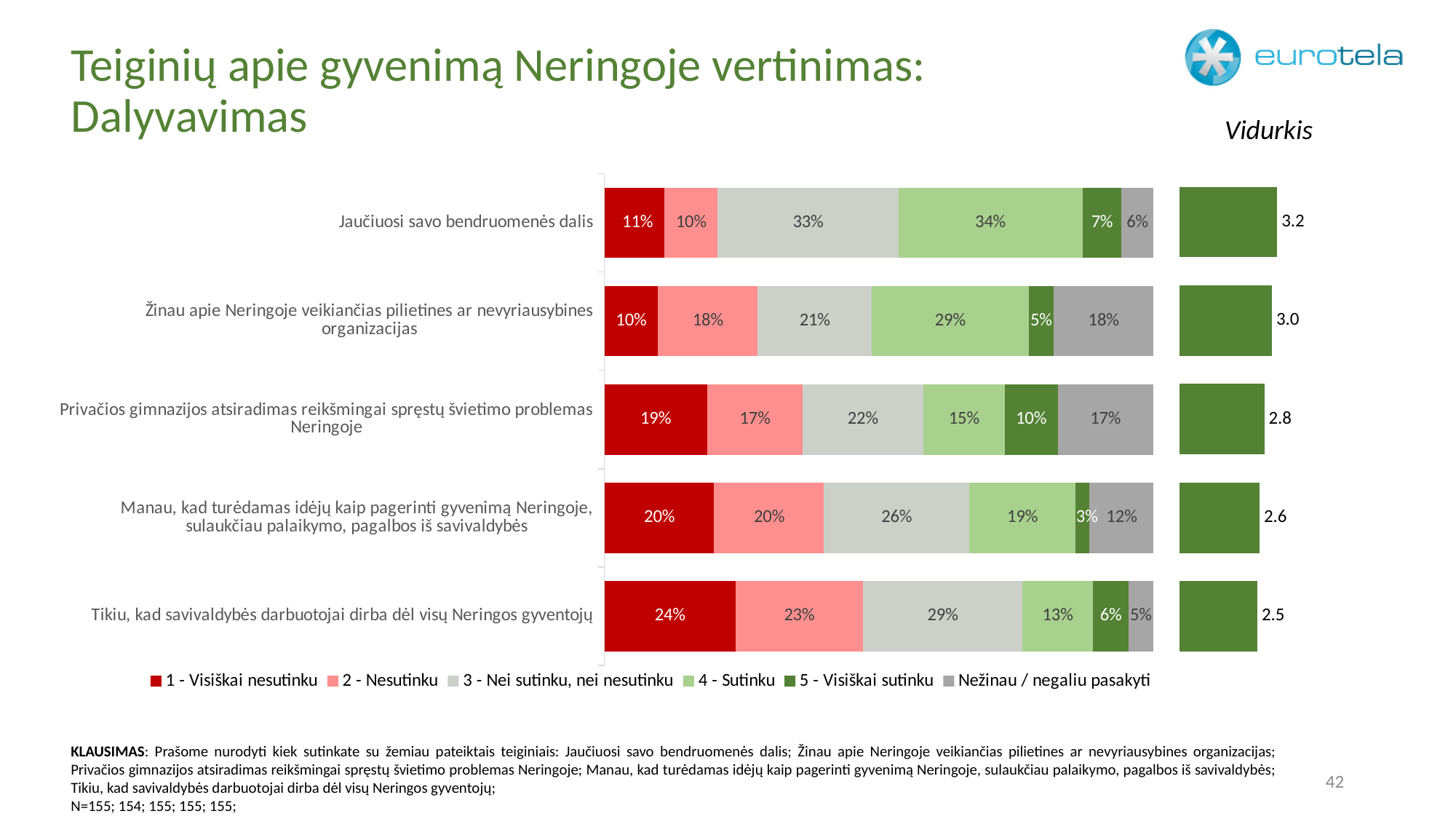
In the stacked bar chart, what percentage answered '1 - Visiškai nesutinku' for 'Tikiu, kad savivaldybės darbuotojai dirba dėl visų Neringos gyventojų'? 24% In the stacked bar chart, what is the difference between the '3 - Nei sutinku, nei nesutinku' shares for 'Jaučiuosi savo bendruomenės dalis' and 'Žinau apie Neringoje veikiančias pilietines ar nevyriausybines organizacijas'? 12% In the stacked bar chart, which is larger: the '5 - Visiškai sutinku' share for 'Privačios gimnazijos atsiradimas reikšmingai spręstų švietimo problemas Neringoje' or for 'Manau, kad turėdamas idėjų kaip pagerinti gyvenimą Neringoje, sulaukčiau palaikymo, pagalbos iš savivaldybės'? Privačios gimnazijos atsiradimas reikšmingai spręstų švietimo problemas Neringoje In the 'Vidurkis' chart on the right, which statement has the highest average? Jaučiuosi savo bendruomenės dalis How many statements (categories) are shown in the stacked bar chart? 5 In the 'Vidurkis' chart on the right, which statement has the lowest average? Tikiu, kad savivaldybės darbuotojai dirba dėl visų Neringos gyventojų How many series does the legend of the stacked bar chart list? 6 What type of chart is the main chart on the slide? Stacked bar chart In the stacked bar chart, what is the 'Nežinau / negaliu pasakyti' share for 'Žinau apie Neringoje veikiančias pilietines ar nevyriausybines organizacijas'? 18% In the stacked bar chart, which statement has the highest '1 - Visiškai nesutinku' share? Tikiu, kad savivaldybės darbuotojai dirba dėl visų Neringos gyventojų In the stacked bar chart, what percentage of respondents answered '4 - Sutinku' for 'Jaučiuosi savo bendruomenės dalis'? 34% In the 'Vidurkis' chart on the right, what is the average for 'Privačios gimnazijos atsiradimas reikšmingai spręstų švietimo problemas Neringoje'? 2.8